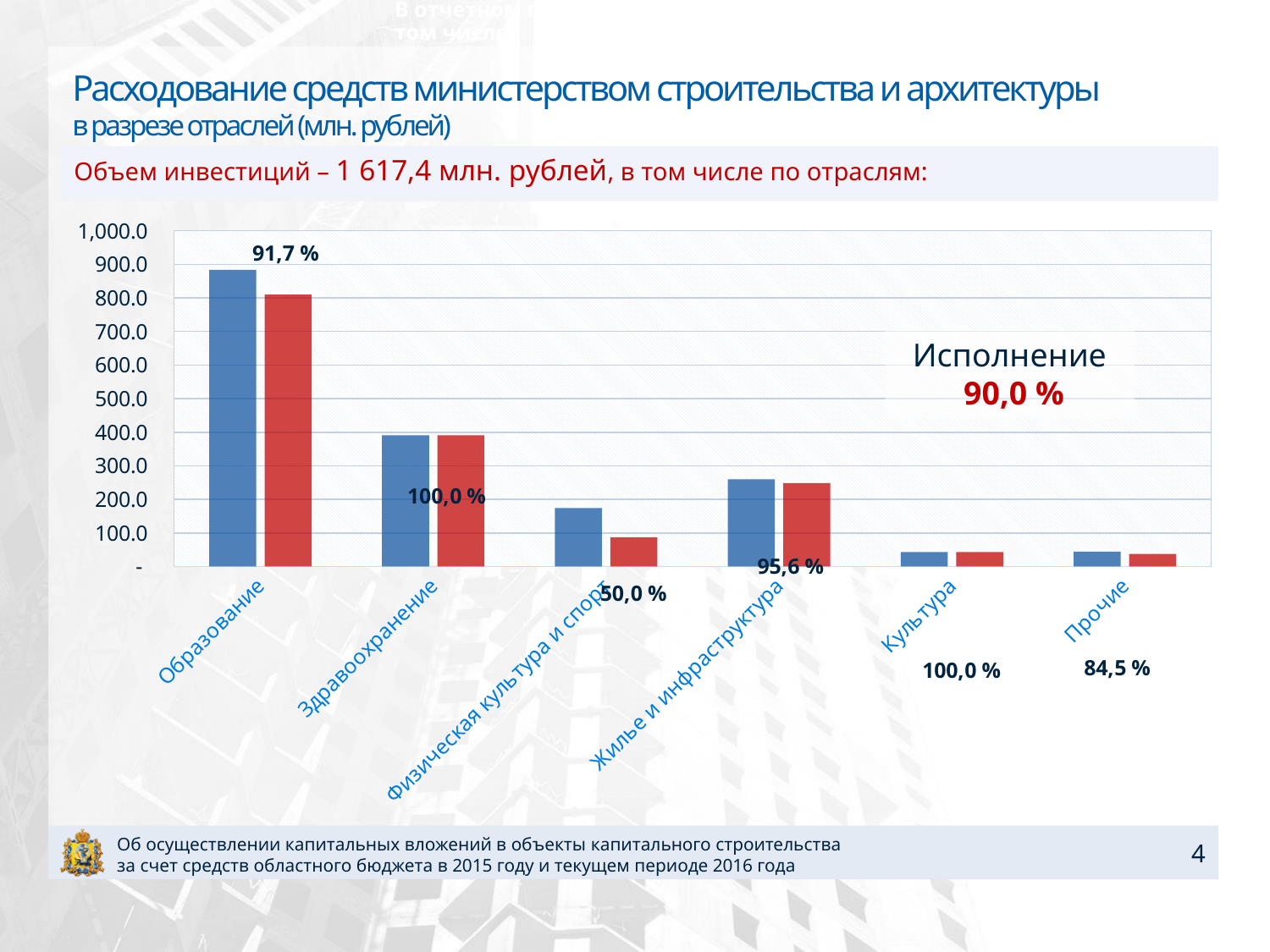
What percentage label is shown for Образование? 91,7 % What overall execution percentage (Исполнение) is shown on the chart? 90,0 % Is the value of the blue bar for Жилье и инфраструктура greater or less than 200? greater Which category has the highest bars in the chart? Образование What percentage label is shown for Физическая культура и спорт? 50,0 % How many categories (industries) are shown on the x axis of the chart? 6 Is the value of the blue bar for Образование greater or less than 800? greater What percentage label is shown for Жилье и инфраструктура? 95,6 % Is the value of the red bar for Физическая культура и спорт greater or less than 100? less Which has the larger blue bar: Здравоохранение or Жилье и инфраструктура? Здравоохранение What percentage label is shown for Прочие? 84,5 % What kind of chart is shown on the slide? bar chart